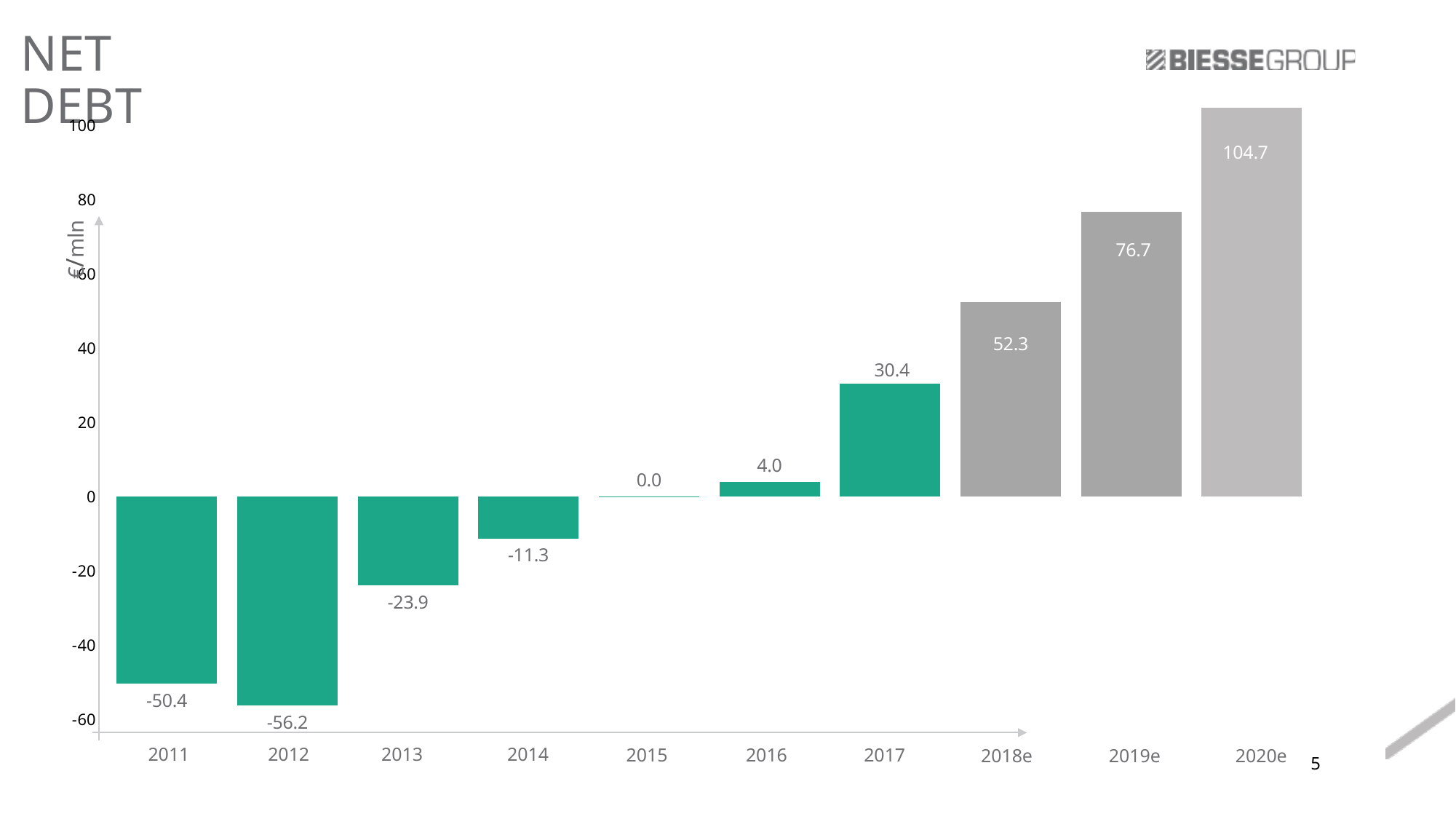
What is the value shown for 2019e? 76.7 What kind of chart is shown on the slide? bar chart How many years are shown on the x axis? 10 Do the values rise or fall from 2012 to 2020e? rise What is the difference between the values for 2017 and 2016? 26.4 Which is larger, the value for 2011 or the value for 2014? 2014 What is the value shown for 2016? 4.0 Which year has the lowest value on the chart? 2012 What is the net debt value for 2013? -23.9 Which year has the highest value on the chart? 2020e What is the difference between the values for 2020e and 2019e? 28.0 What unit is shown on the y axis label? €/mln